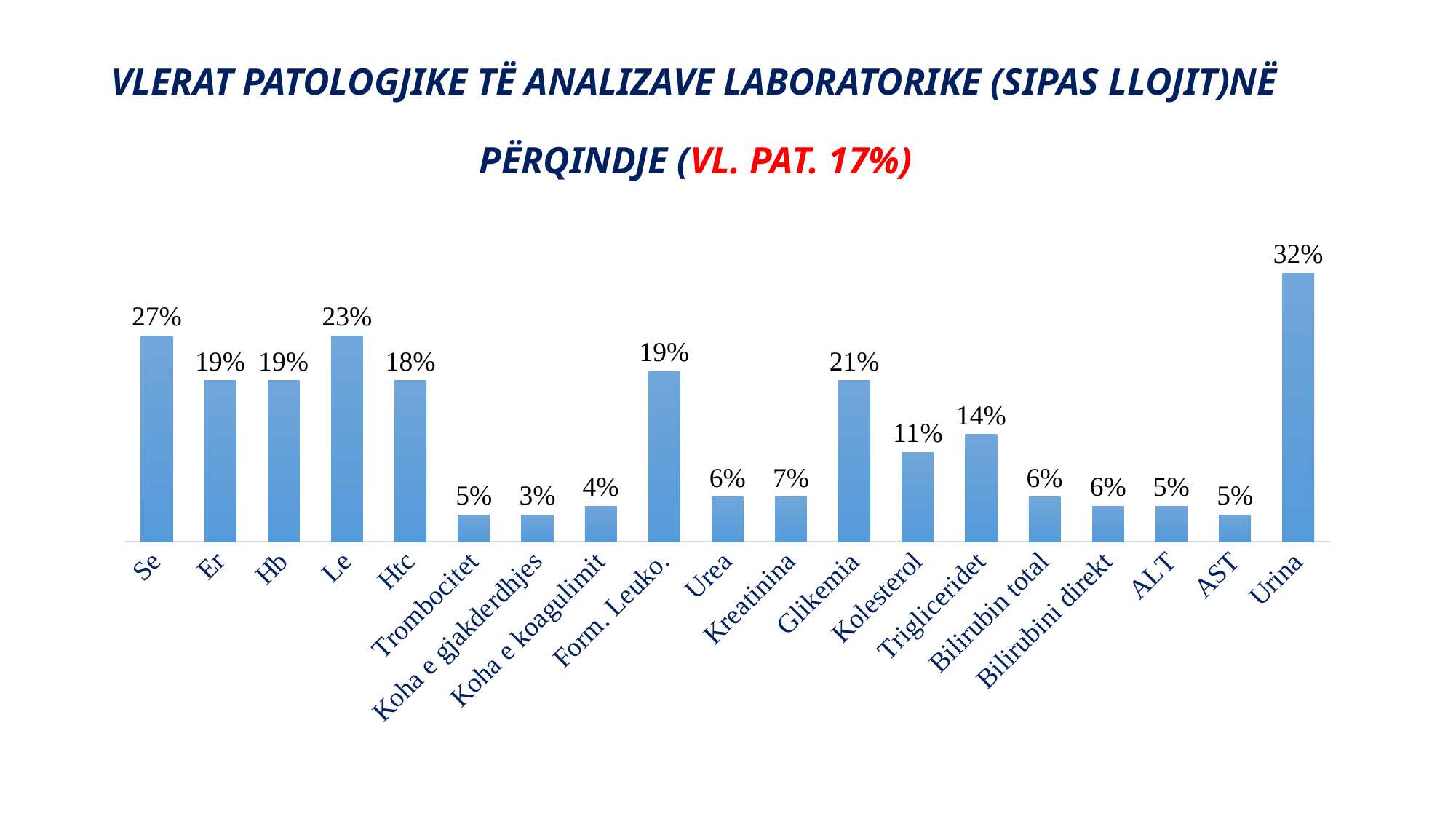
Which is larger, the value for Kolesterol or the value for Trigliceridet? Trigliceridet What is the value for Glikemia? 21% What is the difference between the values for Se and Le? 4% What percentage is shown in red in the slide title? 17% What kind of chart is shown on the slide? Bar chart How many categories are shown on the x axis? 19 Which category has the highest value? Urina What is the value for Trigliceridet? 14% What is the value for Urina? 32% What is the value for Koha e koagulimit? 4% Which category has the lowest value? Koha e gjakderdhjes What is the difference between the values for Urina and Glikemia? 11%